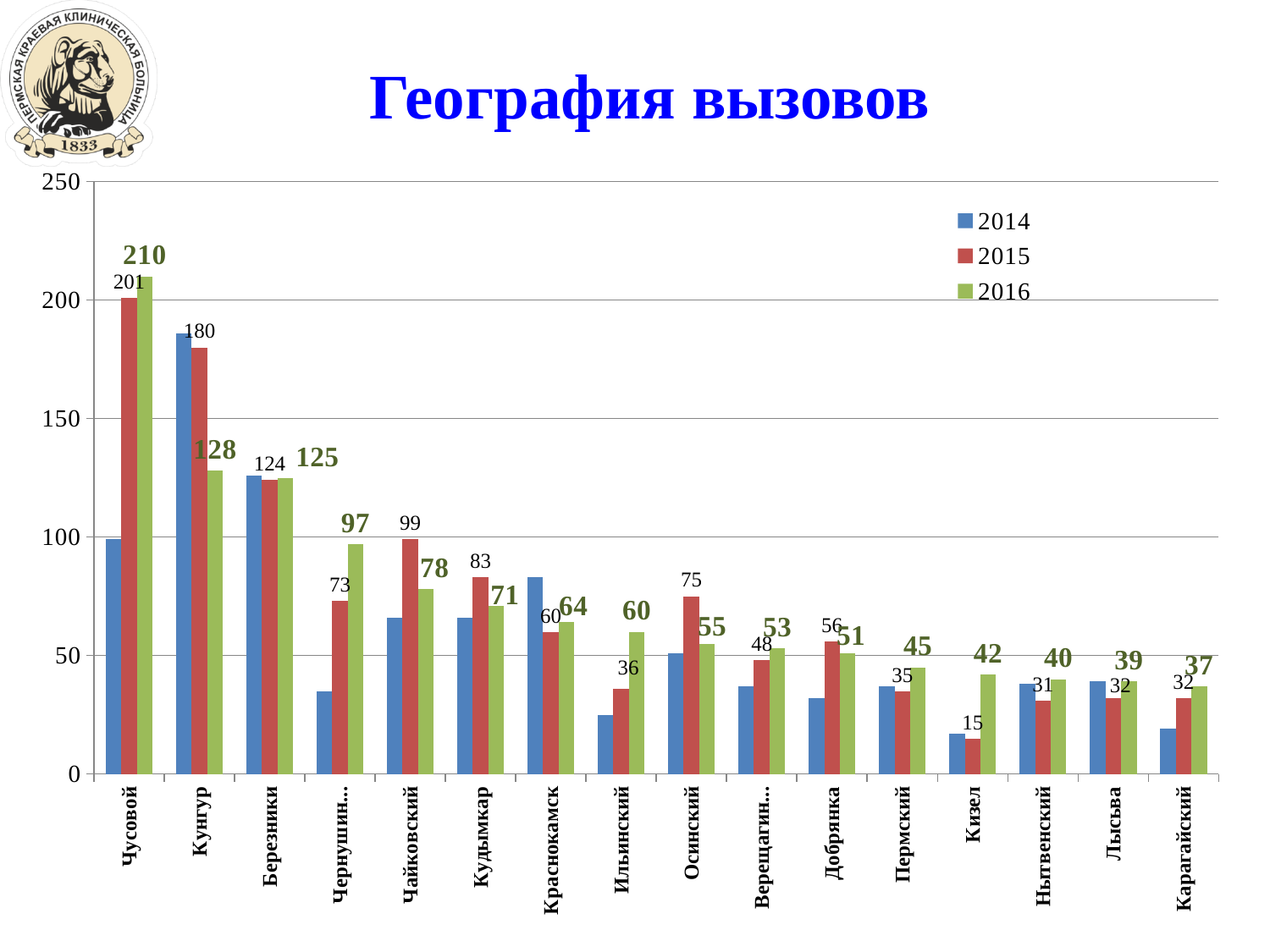
What is the difference between the 2015 and 2016 values for Кунгур? 52 What is the value for Чусовой in the 2016 series? 210 What is the value for Кунгур in the 2015 series? 180 Which category has the lowest value in the 2015 series? Кизел How many series does the legend list? 3 Which category has the highest value in the 2016 series? Чусовой How many categories are shown on the x axis? 16 What is the value for Ильинский in the 2015 series? 36 Do the 2016 values rise or fall from left to right along the x axis? fall For Чайковский, which is larger: the 2015 value or the 2016 value? 2015 What is the difference between the 2016 and 2015 values for Чусовой? 9 Is the 2014 value for Кунгур greater or less than 150? greater